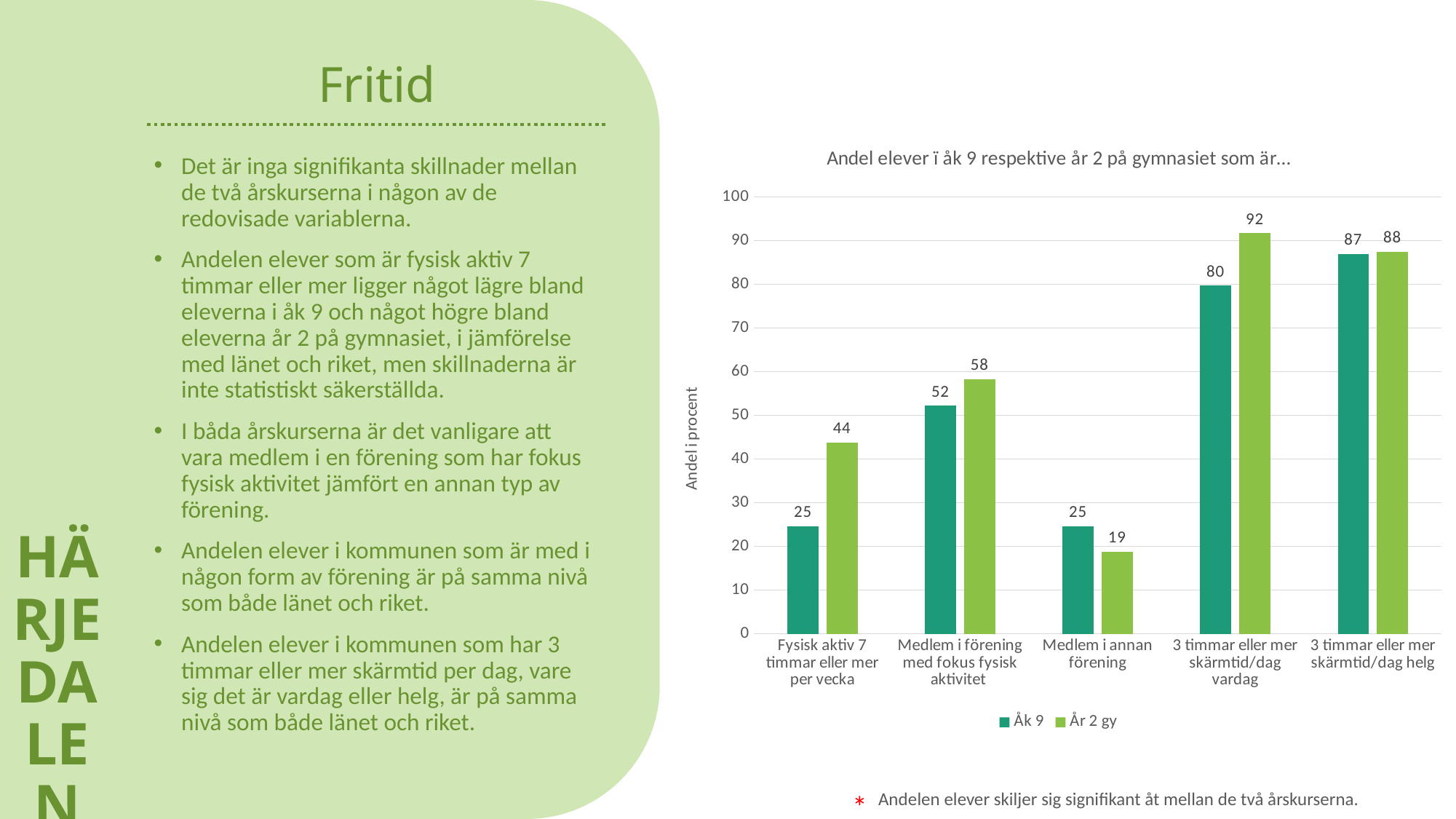
What are the two series listed in the chart legend? Åk 9 and År 2 gy What is the value for År 2 gy in the category 'Medlem i förening med fokus fysisk aktivitet'? 58 What is the value for År 2 gy in the category '3 timmar eller mer skärmtid/dag vardag'? 92 How many categories are shown on the x axis of the chart? 5 What is the value for Åk 9 in the category 'Fysisk aktiv 7 timmar eller mer per vecka'? 25 What is the difference between the År 2 gy and Åk 9 values for 'Fysisk aktiv 7 timmar eller mer per vecka'? 19 What kind of chart is shown on the slide? Bar chart What is the label of the y axis of the chart? Andel i procent Which category has the highest value for Åk 9? 3 timmar eller mer skärmtid/dag helg Which is larger in the category 'Medlem i annan förening': the Åk 9 value or the År 2 gy value? Åk 9 Which category has the lowest value for År 2 gy? Medlem i annan förening How many series does the legend list? 2